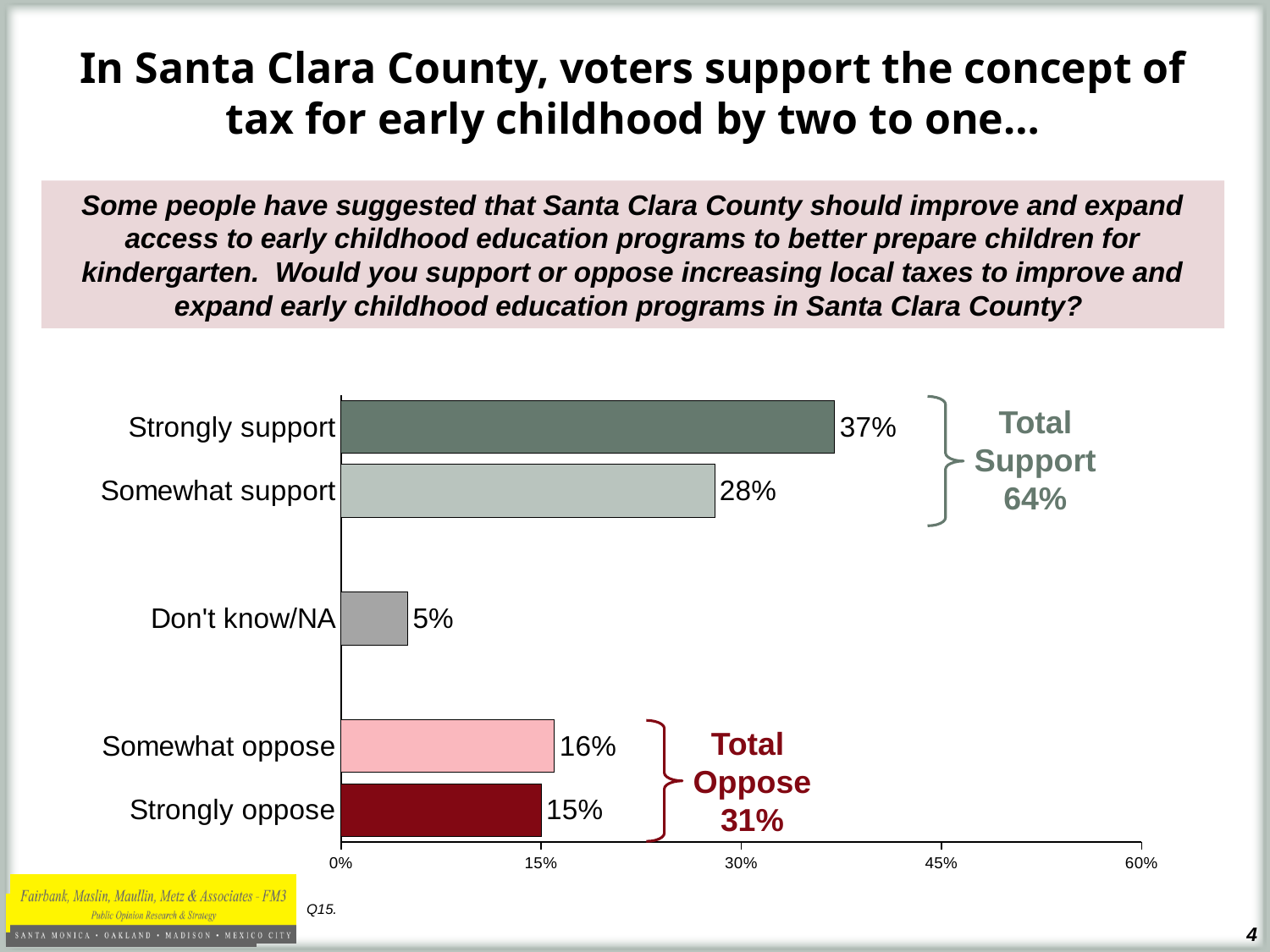
Which category has the lowest value? Don't know/NA Which category has the highest value? Strongly support What is the value for Somewhat support? 28% What is the Total Support percentage shown next to the chart? 64% What percentage of voters strongly support the tax? 37% Is the value for Somewhat support greater or less than 15%? greater How many categories are shown in the chart? 5 What kind of chart is shown on the slide? Bar chart What is the difference between Strongly support and Somewhat support? 9% Which is larger, Somewhat oppose or Strongly oppose? Somewhat oppose What is the value for Strongly oppose? 15% What is the value for Don't know/NA? 5%